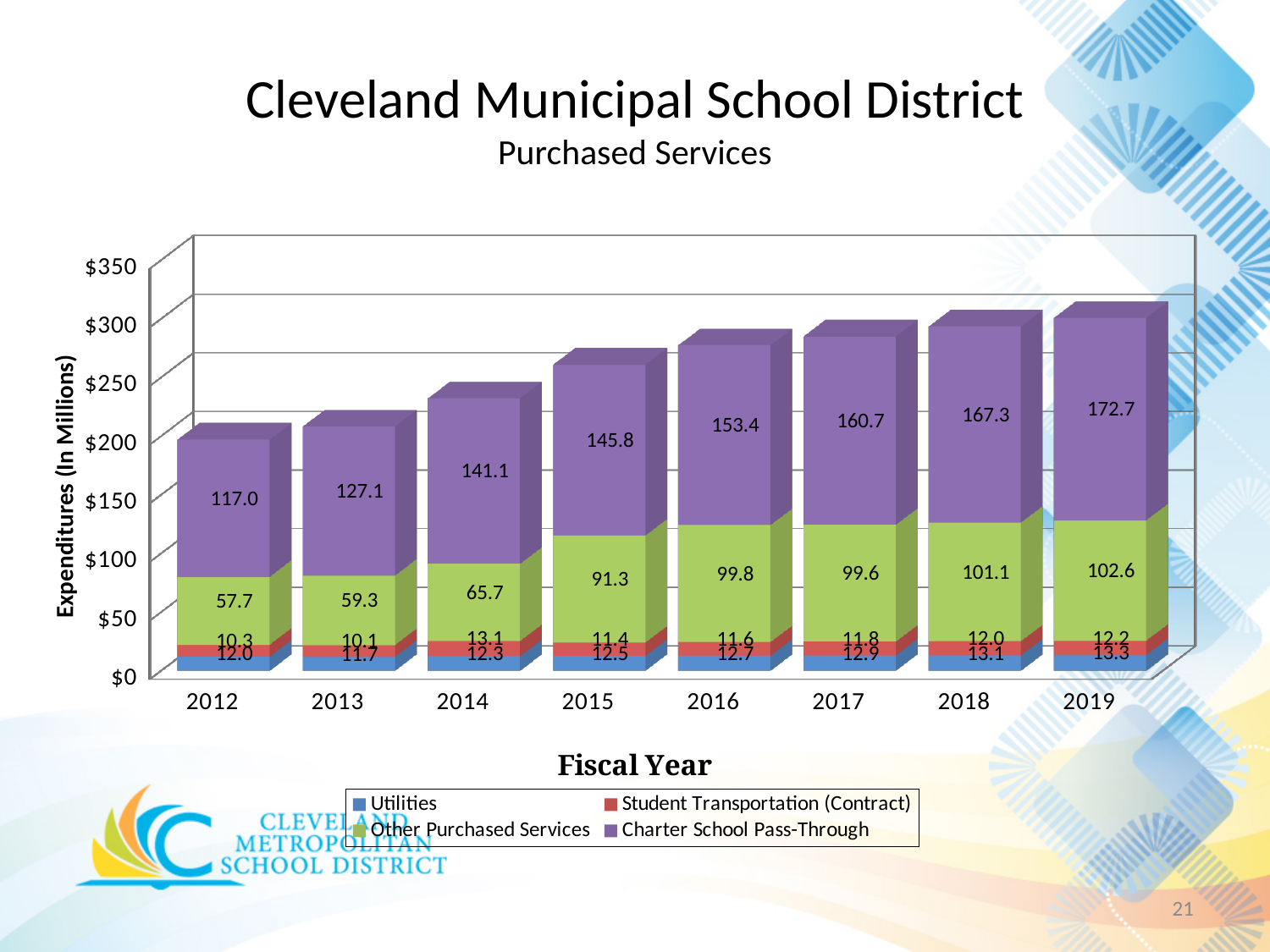
What is the Charter School Pass-Through value for fiscal year 2019? 172.7 What is the Other Purchased Services value for fiscal year 2015? 91.3 What is the difference between the Charter School Pass-Through values for 2019 and 2012? 55.7 What is the Utilities value for fiscal year 2012? 12.0 What is the total of the stacked bar for fiscal year 2012? 197.0 What kind of chart is shown on the slide? Stacked bar chart How many fiscal years are shown on the x axis? 8 How many series does the legend list? 4 Which fiscal year has the highest Charter School Pass-Through value? 2019 Is the total stacked value for fiscal year 2014 greater or less than $250? less Which is larger, the Other Purchased Services value for 2016 or for 2017? 2016 Which fiscal year has the lowest Other Purchased Services value? 2012